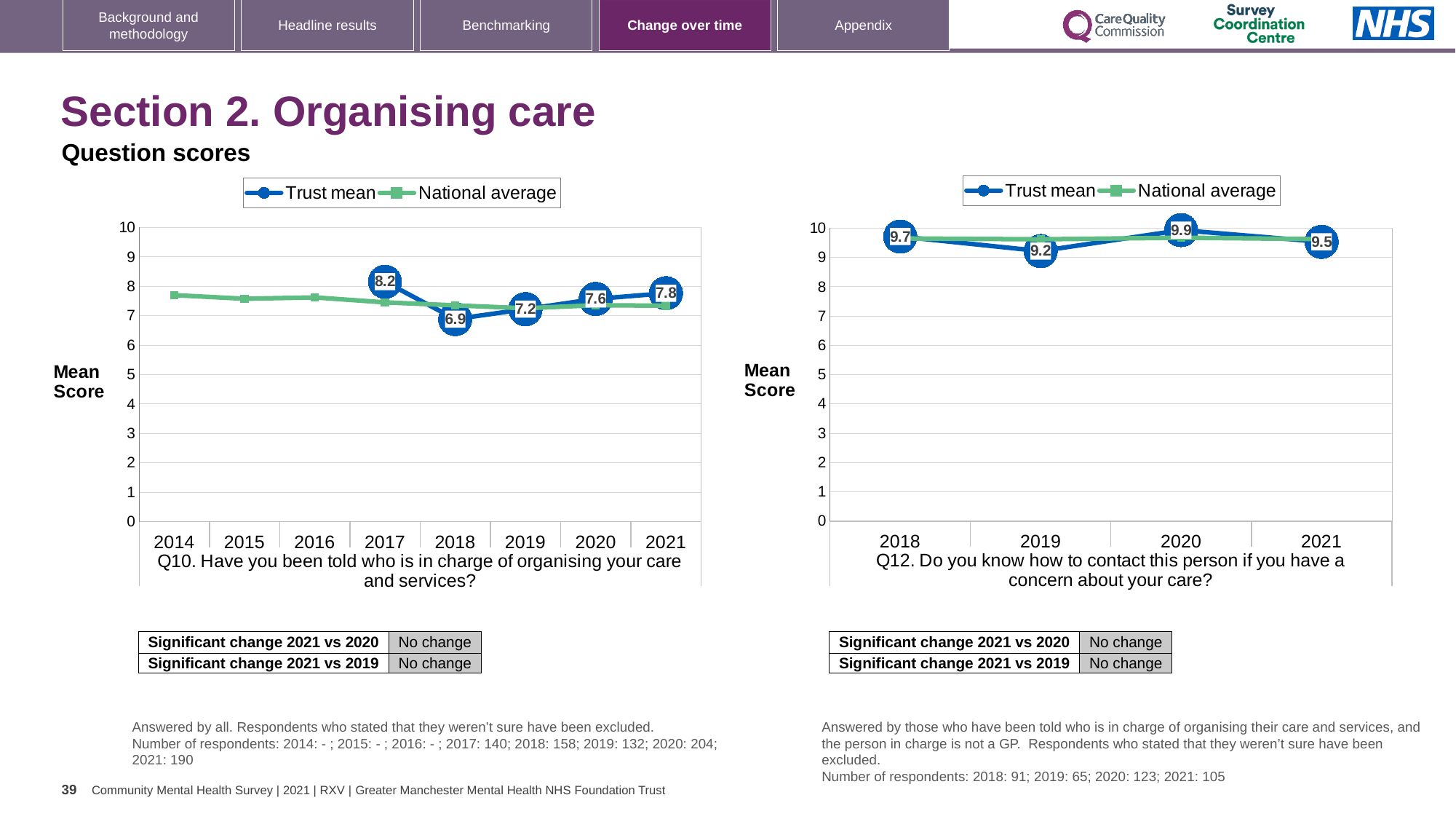
In the Q10 chart (left), which year has the highest Trust mean score? 2017 In the Q10 chart (left), is the National average for 2014 greater or less than 7? greater In the Q12 chart (right), which year has the highest Trust mean score? 2020 In the Q10 chart (left), what is the Trust mean score for 2018? 6.9 In the Q12 chart (right), is the Trust mean score for 2020 or 2021 larger? 2020 In the Q10 chart (left), what is the difference between the Trust mean scores for 2017 and 2018? 1.3 How many series does the legend of the Q12 chart (right) list? 2 In the Q10 chart (left), how many years are shown on the x axis? 8 In the Q10 chart (left), which year has the lowest Trust mean score? 2018 In the Q10 chart (left), what is the Trust mean score for 2021? 7.8 In the Q12 chart (right), what is the difference between the Trust mean scores for 2020 and 2019? 0.7 In the Q12 chart (right), what is the Trust mean score for 2019? 9.2